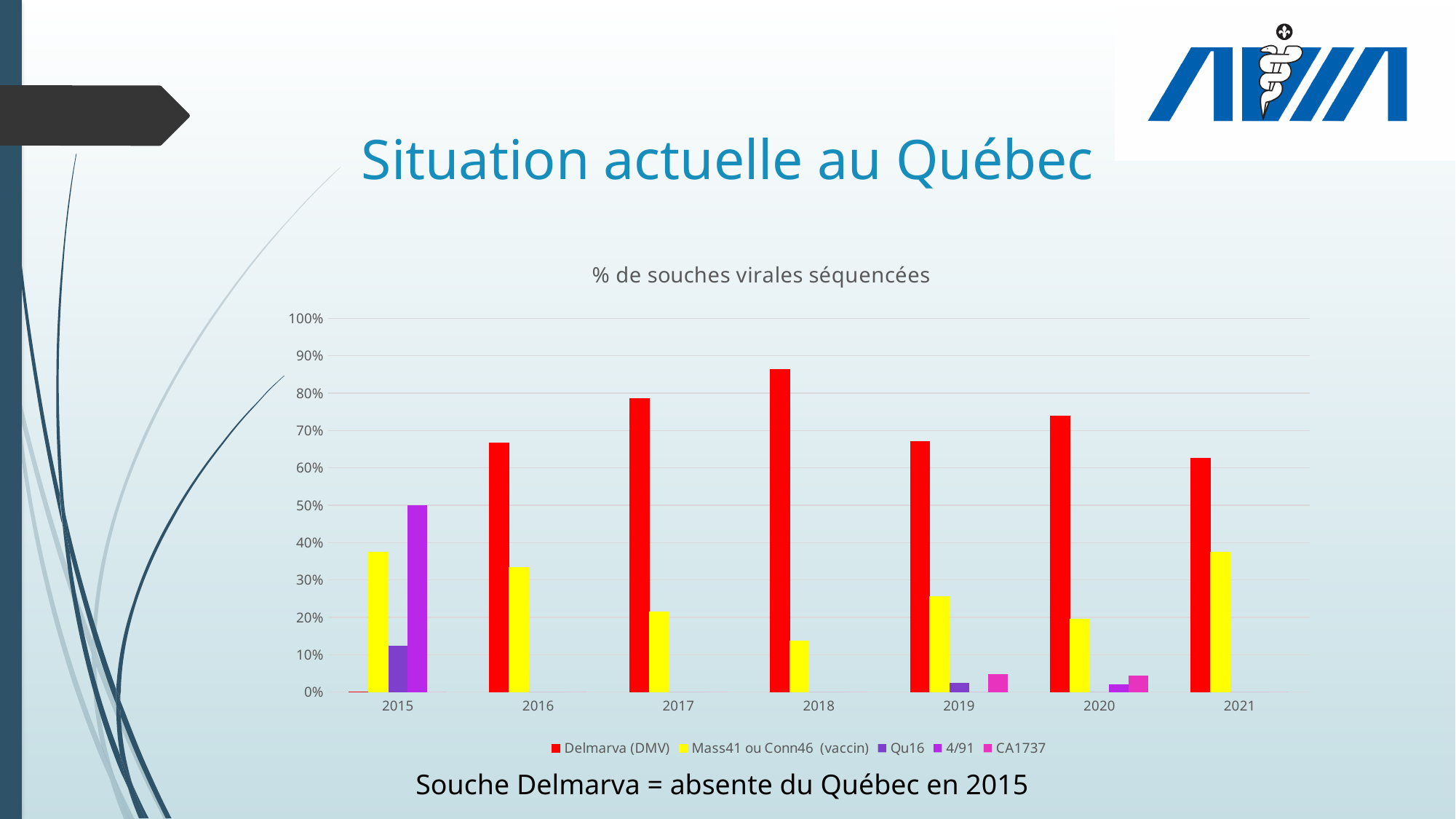
What is the value for 4/91 in 2015? 50% Does the Delmarva (DMV) value rise or fall from 2016 to 2018? rise Is the value for Delmarva (DMV) in 2016 greater or less than 70%? less Among the years 2016 to 2021, in which year is the Mass41 ou Conn46 (vaccin) value lowest? 2018 What kind of chart is shown on the slide? bar chart How many years are shown on the x axis? 7 How many series does the legend list? 5 What colour represents Delmarva (DMV) in the chart? red In which year is the Delmarva (DMV) value highest? 2018 What is the title of the chart? % de souches virales séquencées Which is larger, the Delmarva (DMV) value in 2017 or in 2019? 2017 Is the value for Delmarva (DMV) in 2018 greater or less than 80%? greater